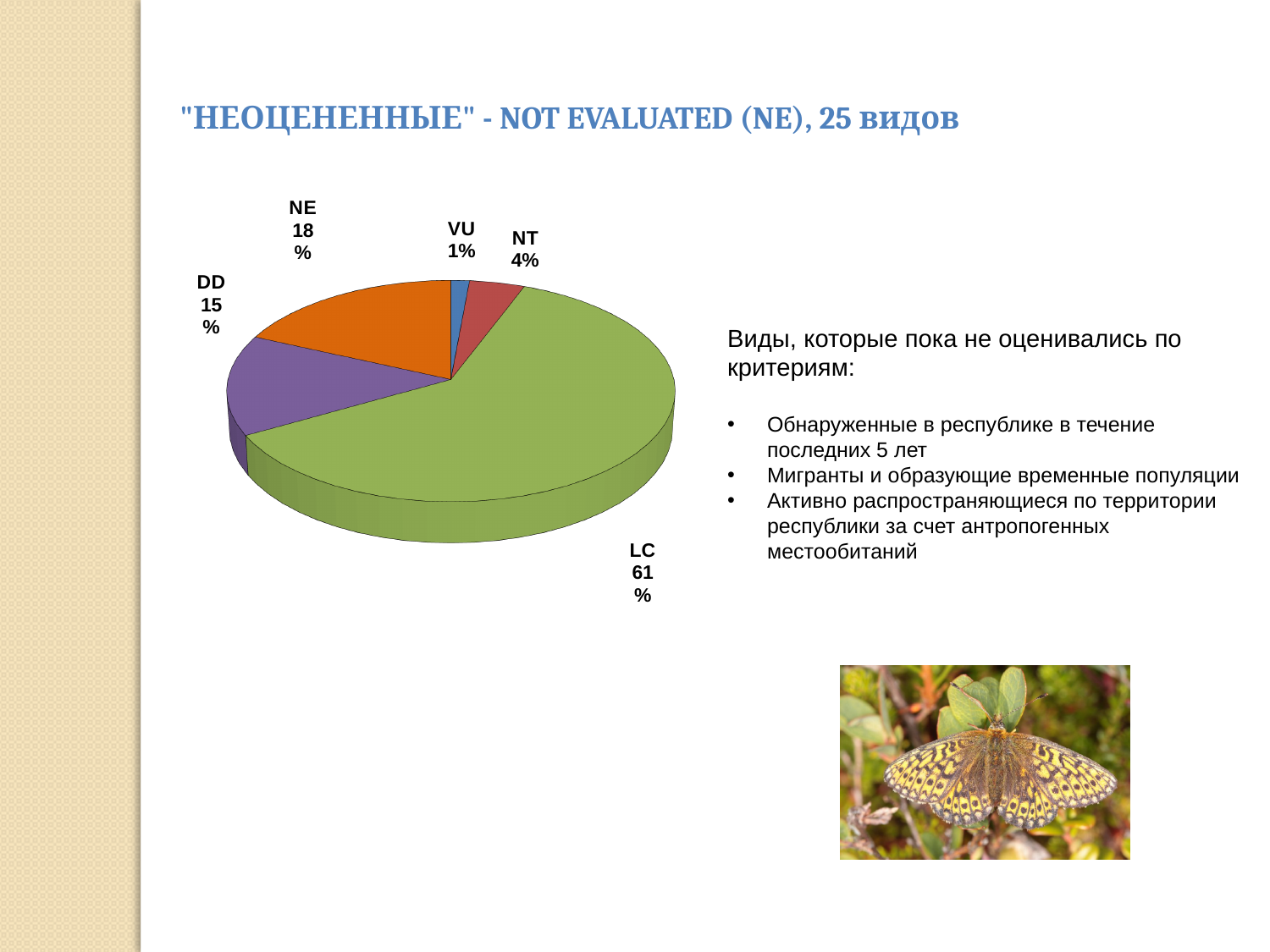
Which category has the largest slice of the pie? LC What share of the pie does VU have? 1% What is the difference in percentage points between the NE and DD slices? 3% What share of the pie does NE have? 18% Which slice is larger, DD or NT? DD What share of the pie does LC have? 61% Which category has the smallest slice of the pie? VU What colour is the LC slice of the pie? green What kind of chart is shown on the slide? pie chart How many slices does the pie chart have? 5